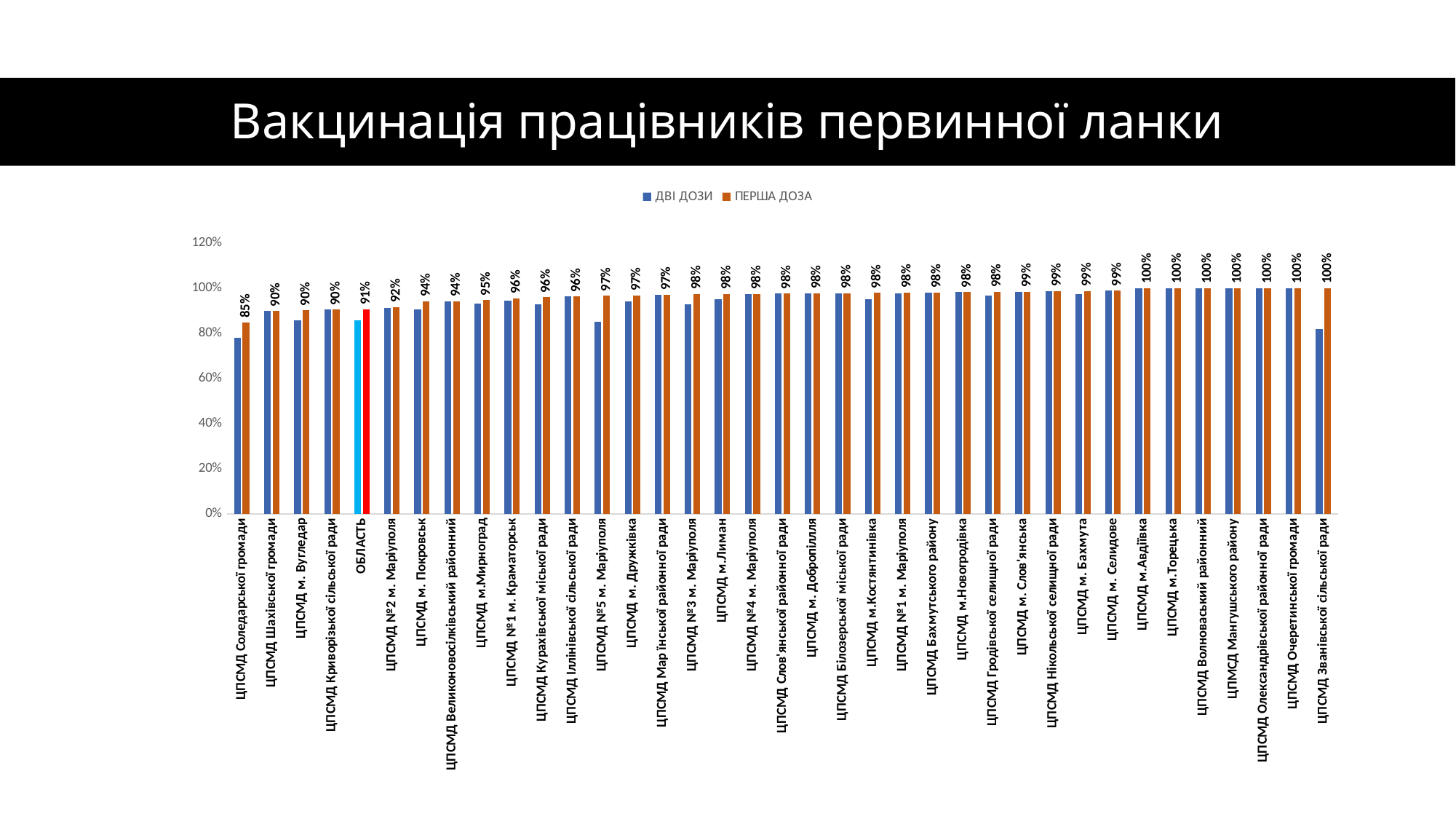
What is the ПЕРША ДОЗА value for ЦПСМД м. Покровськ? 94% What is the ПЕРША ДОЗА value for ЦПСМД Соледарської громади? 85% Do the ПЕРША ДОЗА values generally rise or fall from left to right along the x axis? rise Which category has the lowest ПЕРША ДОЗА value? ЦПСМД Соледарської громади How many series does the legend list? 2 What is the difference between the ПЕРША ДОЗА values for ОБЛАСТЬ and ЦПСМД Соледарської громади? 6 percentage points What is the ПЕРША ДОЗА value for ОБЛАСТЬ? 91% Is the ДВІ ДОЗИ value for ЦПСМД Соледарської громади greater or less than 80%? less What kind of chart is shown on the slide? bar chart What is the ПЕРША ДОЗА value for ЦПСМД м. Бахмута? 99% How many categories are shown on the x axis? 37 Which has a higher ПЕРША ДОЗА value: ЦПСМД м. Вугледар or ЦПСМД м.Мирноград? ЦПСМД м.Мирноград